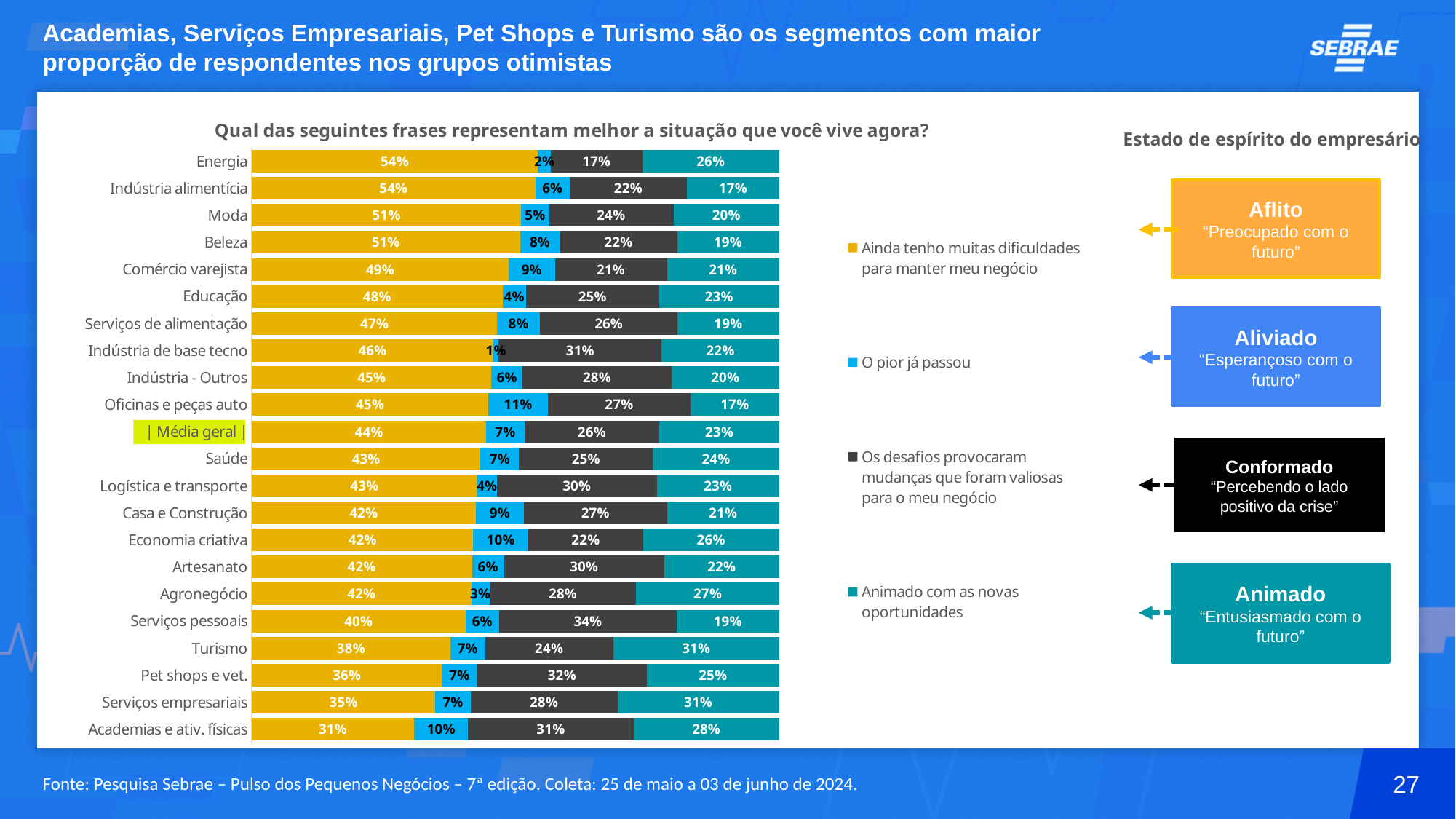
Which category has the lowest value for 'Ainda tenho muitas dificuldades para manter meu negócio'? Academias e ativ. físicas What is the value for 'Ainda tenho muitas dificuldades para manter meu negócio' in the Energia row? 54% What is the value for 'Os desafios provocaram mudanças que foram valiosas para o meu negócio' in the Serviços pessoais row? 34% What is the difference between the 'Ainda tenho muitas dificuldades para manter meu negócio' values for Energia and Academias e ativ. físicas? 23% How many series does the chart legend list? 4 What is the value for 'O pior já passou' in the Oficinas e peças auto row? 11% What type of chart is shown on the slide? stacked bar chart Which is larger: the 'Animado com as novas oportunidades' value for Agronegócio or for Saúde? Agronegócio Which category has the highest value for 'O pior já passou'? Oficinas e peças auto How many categories (rows) are plotted in the chart, including Média geral? 22 What is the total of the Média geral bar across all four series? 100% What is the value for 'Animado com as novas oportunidades' in the Turismo row? 31%